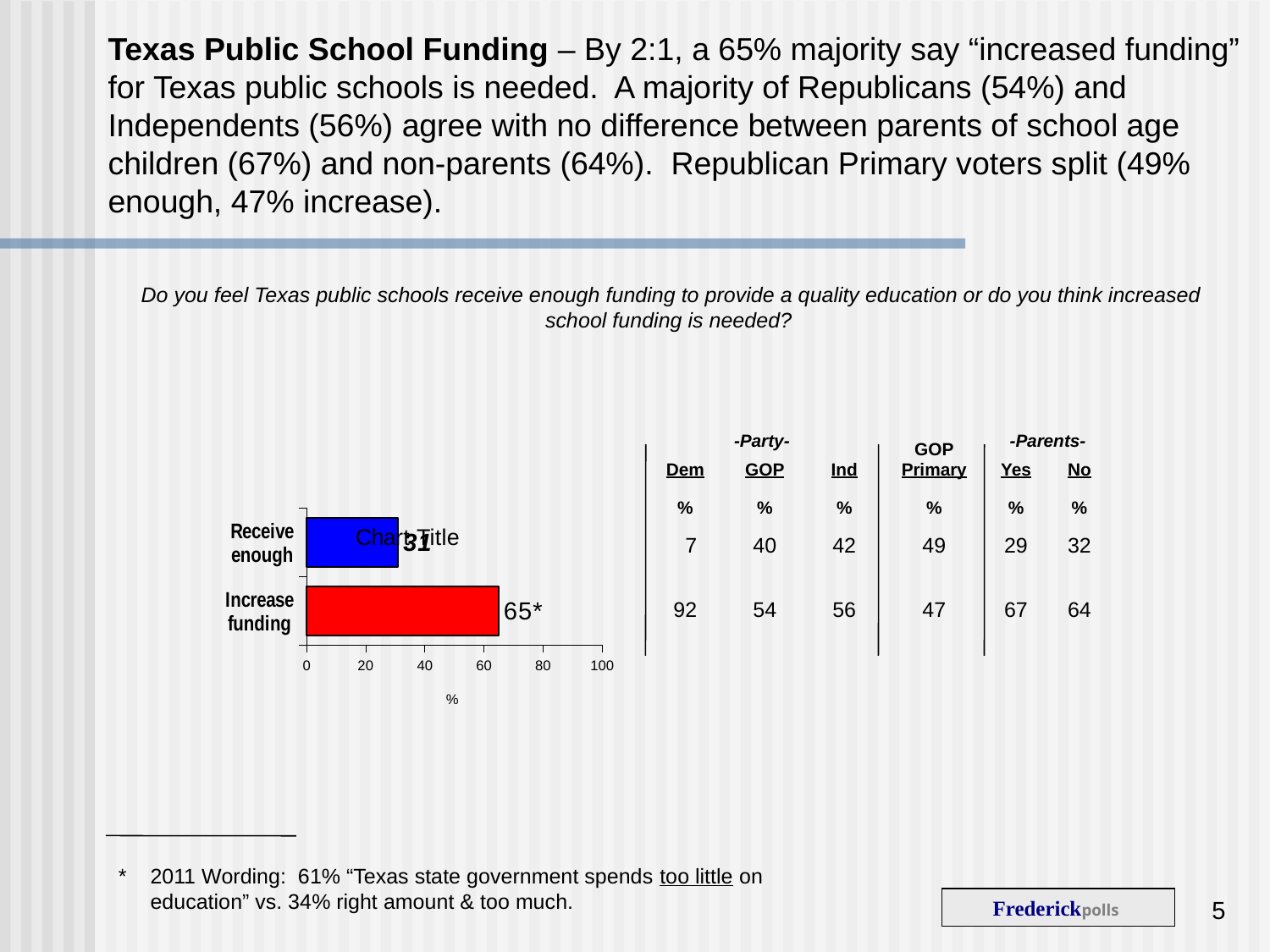
Which is larger in the bar chart, "Receive enough" or "Increase funding"? Increase funding What is the value for "Increase funding" in the bar chart? 65 Is the value for "Increase funding" greater or less than 60? greater What colour is the "Increase funding" bar in the chart? red What type of chart is shown on the slide? bar chart Which category has the highest value in the bar chart? Increase funding Is the value for "Receive enough" greater or less than 40? less Which category has the lowest value in the bar chart? Receive enough What is the difference between the values for "Increase funding" and "Receive enough" in the bar chart? 34 How many categories does the bar chart show? 2 What is the value for "Receive enough" in the bar chart? 31 What is the label on the horizontal axis of the bar chart? %